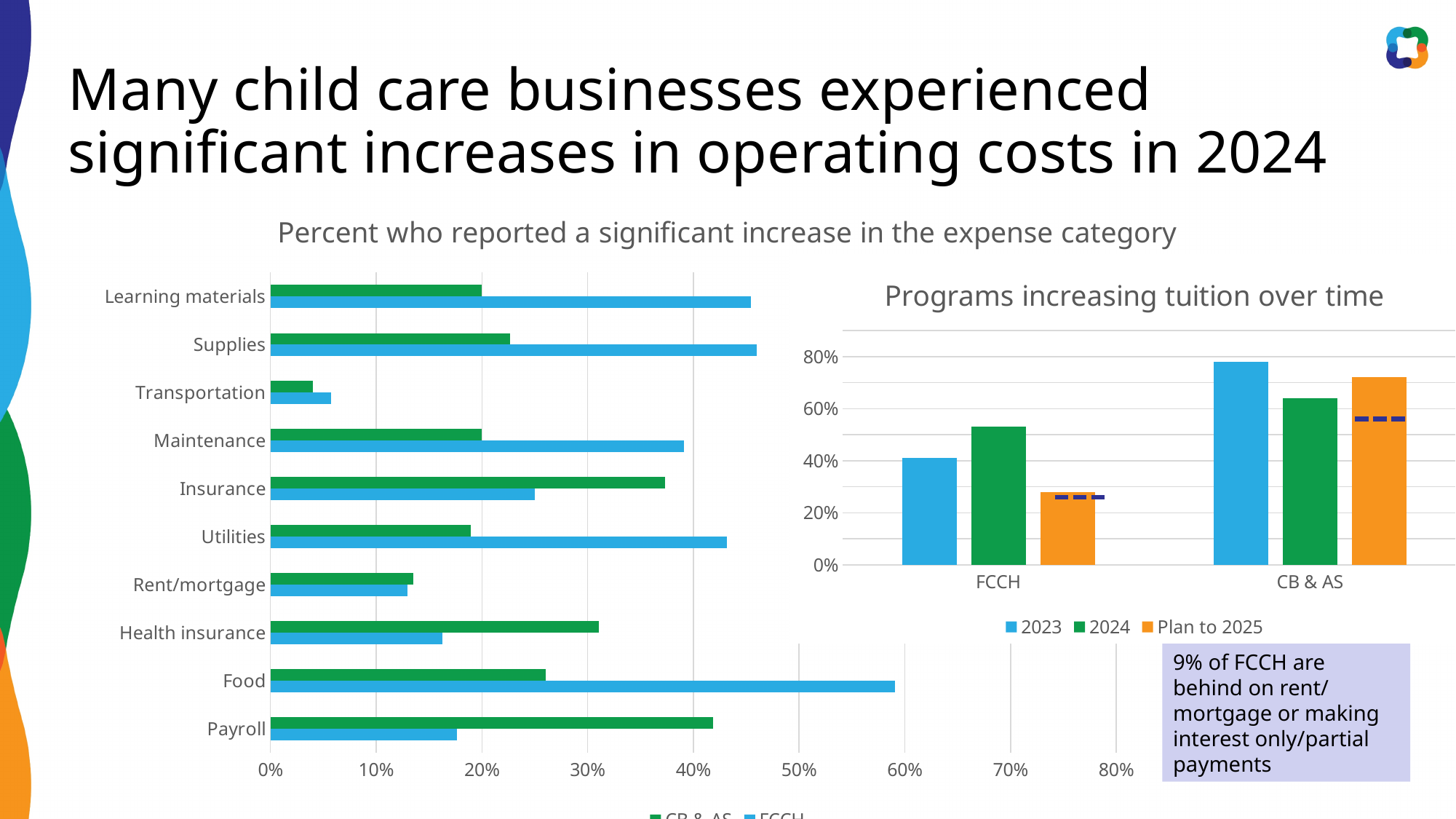
In the chart titled "Percent who reported a significant increase in the expense category", is the CB & AS value for Transportation greater or less than 10%? less In the chart titled "Percent who reported a significant increase in the expense category", which is larger for Payroll: CB & AS or FCCH? CB & AS In the chart titled "Percent who reported a significant increase in the expense category", which expense category has the highest FCCH value? Food How many expense categories are shown in the chart titled "Percent who reported a significant increase in the expense category"? 10 In the chart titled "Percent who reported a significant increase in the expense category", which expense category has the lowest CB & AS value? Transportation In the chart titled "Programs increasing tuition over time", which bar is the highest? CB & AS, 2023 In the chart titled "Percent who reported a significant increase in the expense category", which is larger for Health insurance: CB & AS or FCCH? CB & AS In the chart titled "Percent who reported a significant increase in the expense category", is the FCCH value for Food greater or less than 50%? greater What kind of chart is the chart titled "Percent who reported a significant increase in the expense category"? Bar chart How many series does the legend list in the chart titled "Programs increasing tuition over time"? 3 In the chart titled "Programs increasing tuition over time", which is larger for FCCH: 2023 or 2024? 2024 In the chart titled "Programs increasing tuition over time", is the 2023 value for CB & AS greater or less than 70%? greater